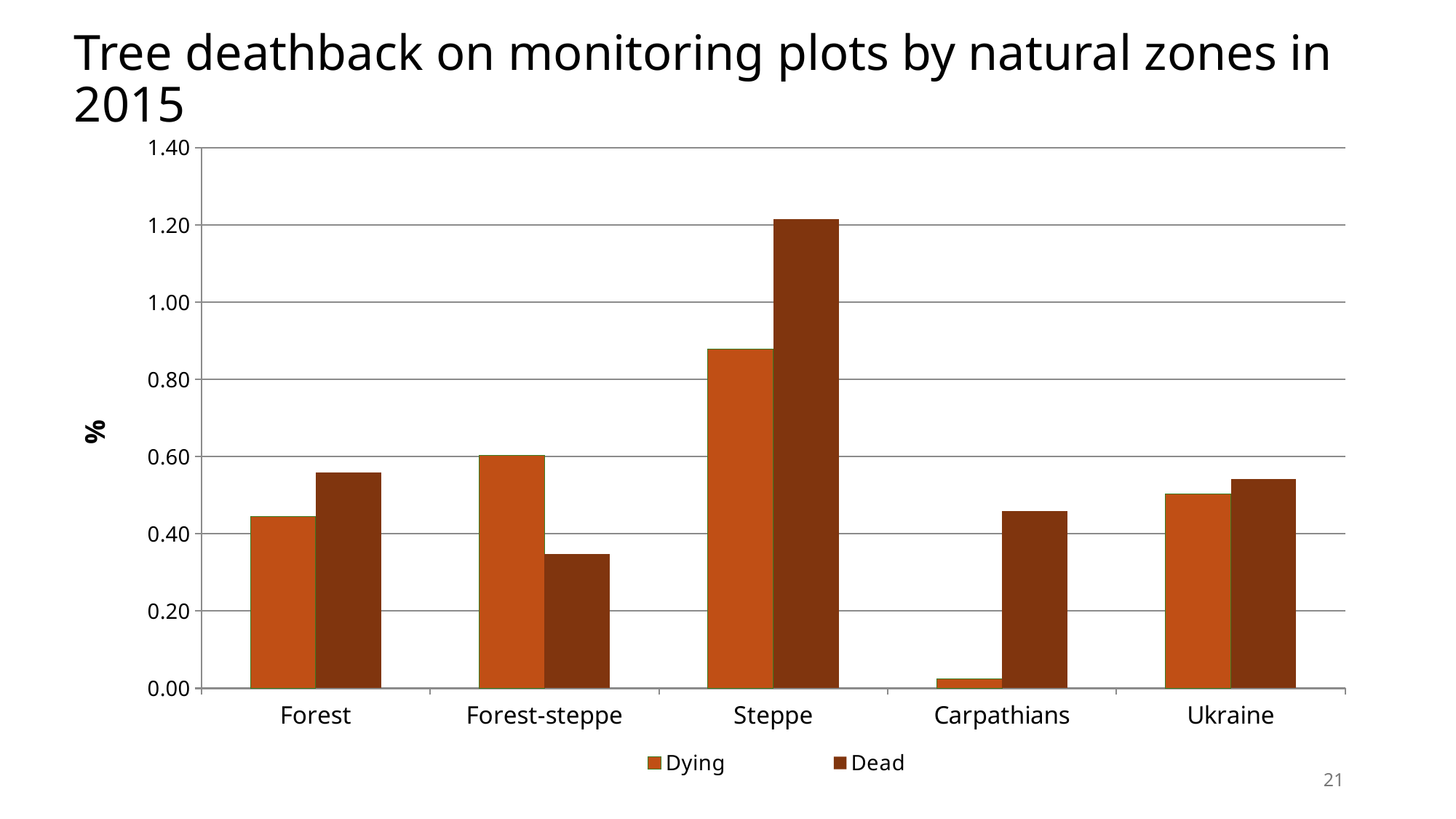
What kind of chart is shown on the slide? bar chart Which natural zone has the highest Dying value? Steppe Which natural zone has the lowest Dead value? Forest-steppe How many natural zones are shown on the x axis? 5 Which natural zone has the lowest Dying value? Carpathians How many series does the legend list? 2 For Forest-steppe, which is larger, the Dying value or the Dead value? Dying What is the label on the y axis? % Is the Dead value for Steppe greater or less than 1.00? greater Is the Dead value for Forest-steppe greater or less than 0.40? less Is the Dying value for Carpathians greater or less than 0.20? less Which natural zone has the highest Dead value? Steppe